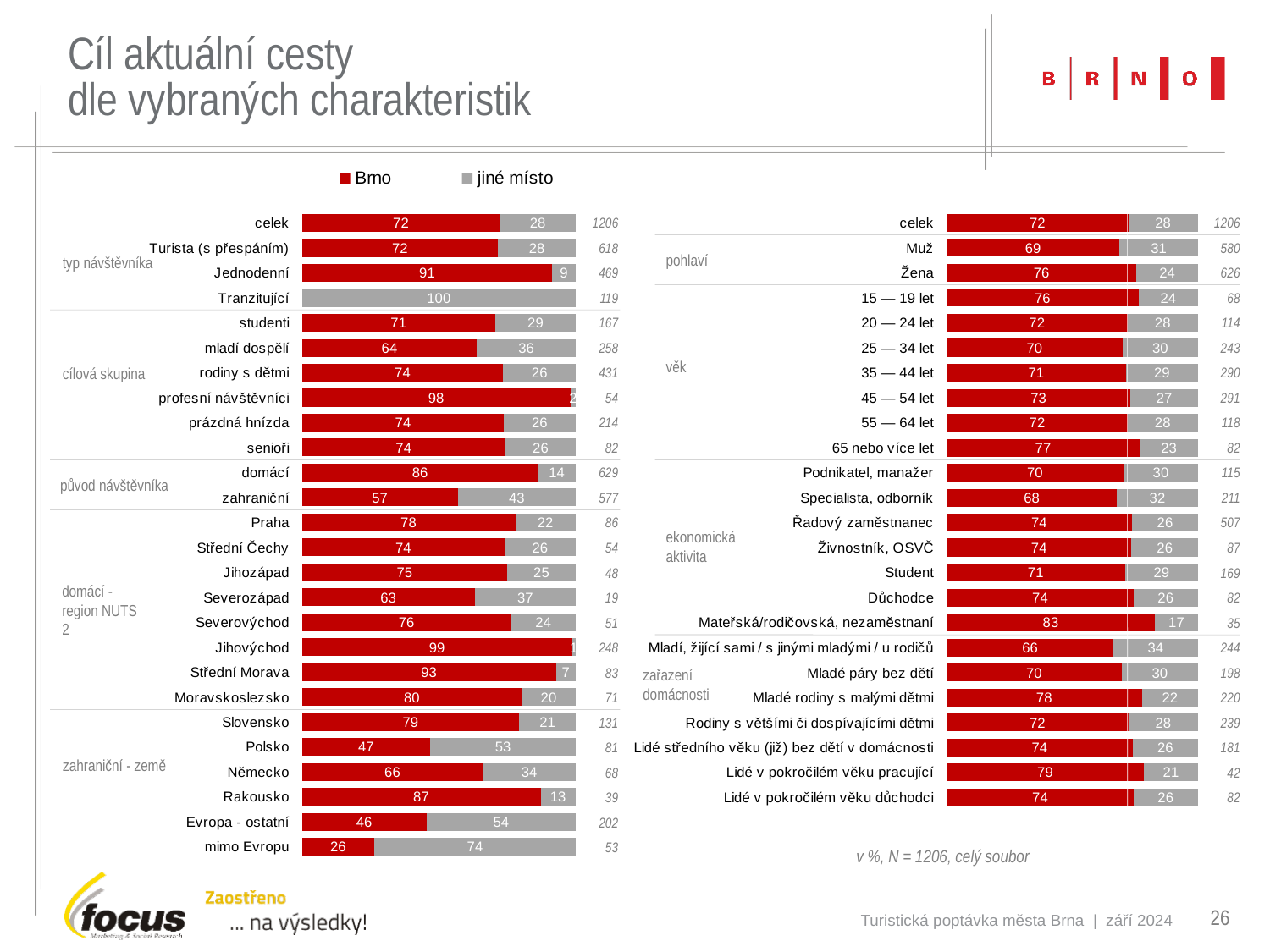
In the right chart, what is the Brno value for 'Mateřská/rodičovská, nezaměstnaní'? 83 How many series does the legend list? 2 In the right chart, which category has the lowest Brno value? Mladí, žijící sami / s jinými mladými / u rodičů What type of chart is shown on the slide? Stacked bar chart In the right chart, what is the 'jiné místo' value for 'Specialista, odborník'? 32 In the left chart, what is the Brno value for 'mimo Evropu'? 26 In the right chart, what is the difference between the Brno values for '65 nebo více let' and '25 — 34 let'? 7 In the left chart, what is the difference between the Brno values for 'Rakousko' and 'Polsko'? 40 In the left chart, which category has the highest Brno value? Jihovýchod In the right chart, which has a larger Brno value, 'Muž' or 'Žena'? Žena In the left chart, what is the 'jiné místo' value for 'zahraniční'? 43